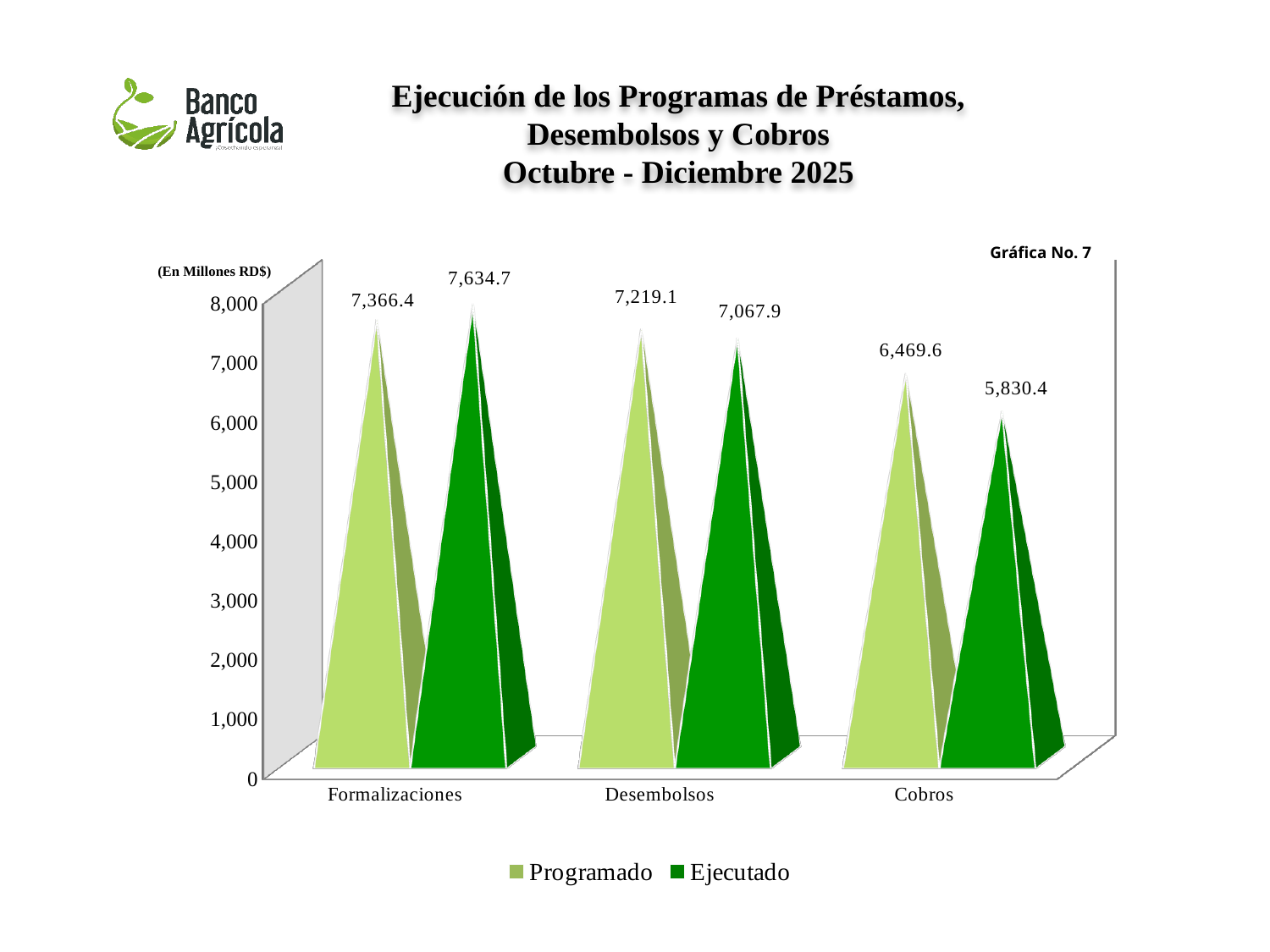
What is the Programado value for Formalizaciones? 7,366.4 For Desembolsos, which is larger: Programado or Ejecutado? Programado How many series does the legend list? 2 How many categories are shown on the x axis? 3 What kind of chart is shown on the slide? Bar chart What is the Ejecutado value for Desembolsos? 7,067.9 What is the difference between the Ejecutado and Programado values for Formalizaciones? 268.3 What is the Ejecutado value for Cobros? 5,830.4 What is the difference between the Programado and Ejecutado values for Cobros? 639.2 What unit is stated for the values in the chart? En Millones RD$ Which category has the highest Ejecutado value? Formalizaciones Which category has the lowest Programado value? Cobros